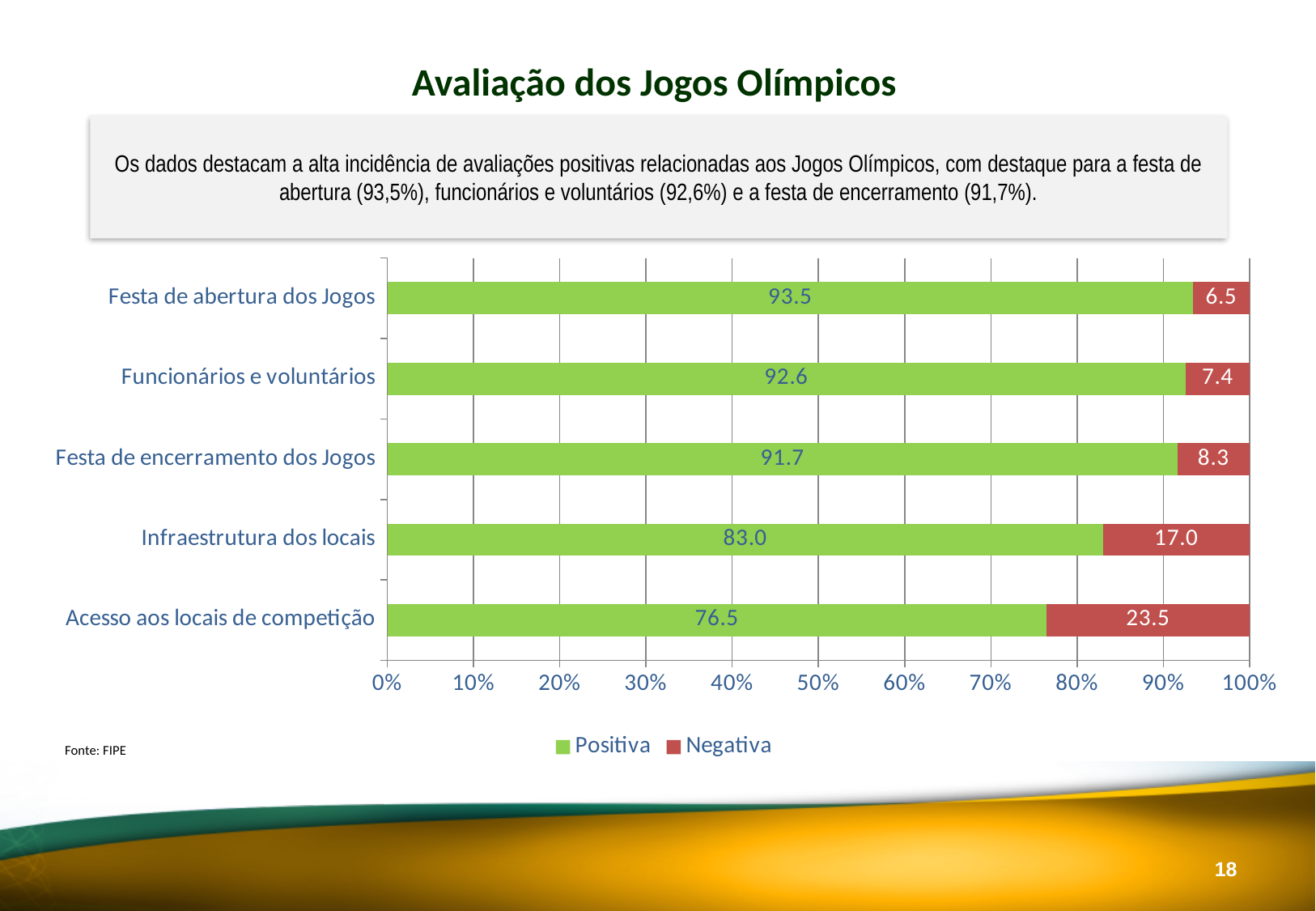
What is the Negativa value for Infraestrutura dos locais? 17.0 How many series does the legend list? 2 What is the difference between the Positiva values for Festa de abertura dos Jogos and Infraestrutura dos locais? 10.5 Which is larger: the Negativa value for Funcionários e voluntários or for Festa de encerramento dos Jogos? Festa de encerramento dos Jogos What is the total of the stacked bar for Infraestrutura dos locais? 100.0 How many categories are shown in the chart? 5 Which category has the highest Negativa value? Acesso aos locais de competição What kind of chart is shown on the slide? Stacked bar chart What is the title of the slide? Avaliação dos Jogos Olímpicos What is the Positiva value for Acesso aos locais de competição? 76.5 Which category has the lowest Positiva value? Acesso aos locais de competição What is the Positiva value for Festa de abertura dos Jogos? 93.5